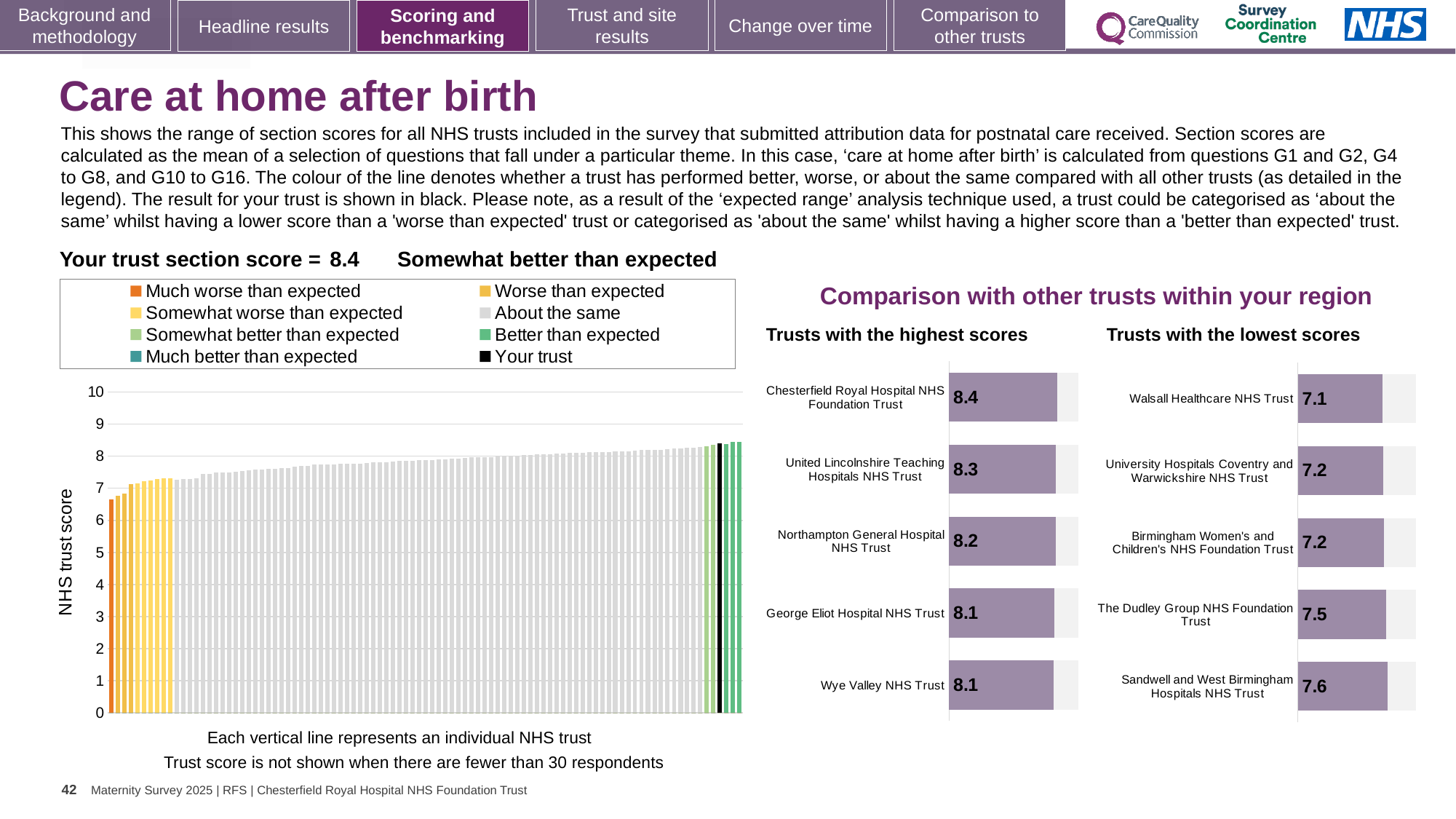
In the 'Trusts with the lowest scores' chart, what is the difference between the scores of Sandwell and West Birmingham Hospitals NHS Trust and Walsall Healthcare NHS Trust? 0.5 In the 'Trusts with the highest scores' chart, what is the score for Chesterfield Royal Hospital NHS Foundation Trust? 8.4 In the 'Trusts with the lowest scores' chart, which has the larger score: The Dudley Group NHS Foundation Trust or Walsall Healthcare NHS Trust? The Dudley Group NHS Foundation Trust How many trusts are shown in the 'Trusts with the highest scores' chart? 5 In the 'Trusts with the lowest scores' chart, which trust has the highest score? Sandwell and West Birmingham Hospitals NHS Trust In the large 'NHS trust score' chart on the left, is the value of the black bar (your trust) greater or less than 8? greater In the 'Trusts with the lowest scores' chart, what is the score for Walsall Healthcare NHS Trust? 7.1 In the large 'NHS trust score' chart on the left, do the bar values rise or fall from left to right? rise In the 'Trusts with the highest scores' chart, what is the score for Northampton General Hospital NHS Trust? 8.2 In the 'Trusts with the lowest scores' chart, which trust has the lowest score? Walsall Healthcare NHS Trust How many entries does the legend above the large 'NHS trust score' chart list? 8 In the 'Trusts with the highest scores' chart, what is the difference between the scores of Chesterfield Royal Hospital NHS Foundation Trust and Northampton General Hospital NHS Trust? 0.2